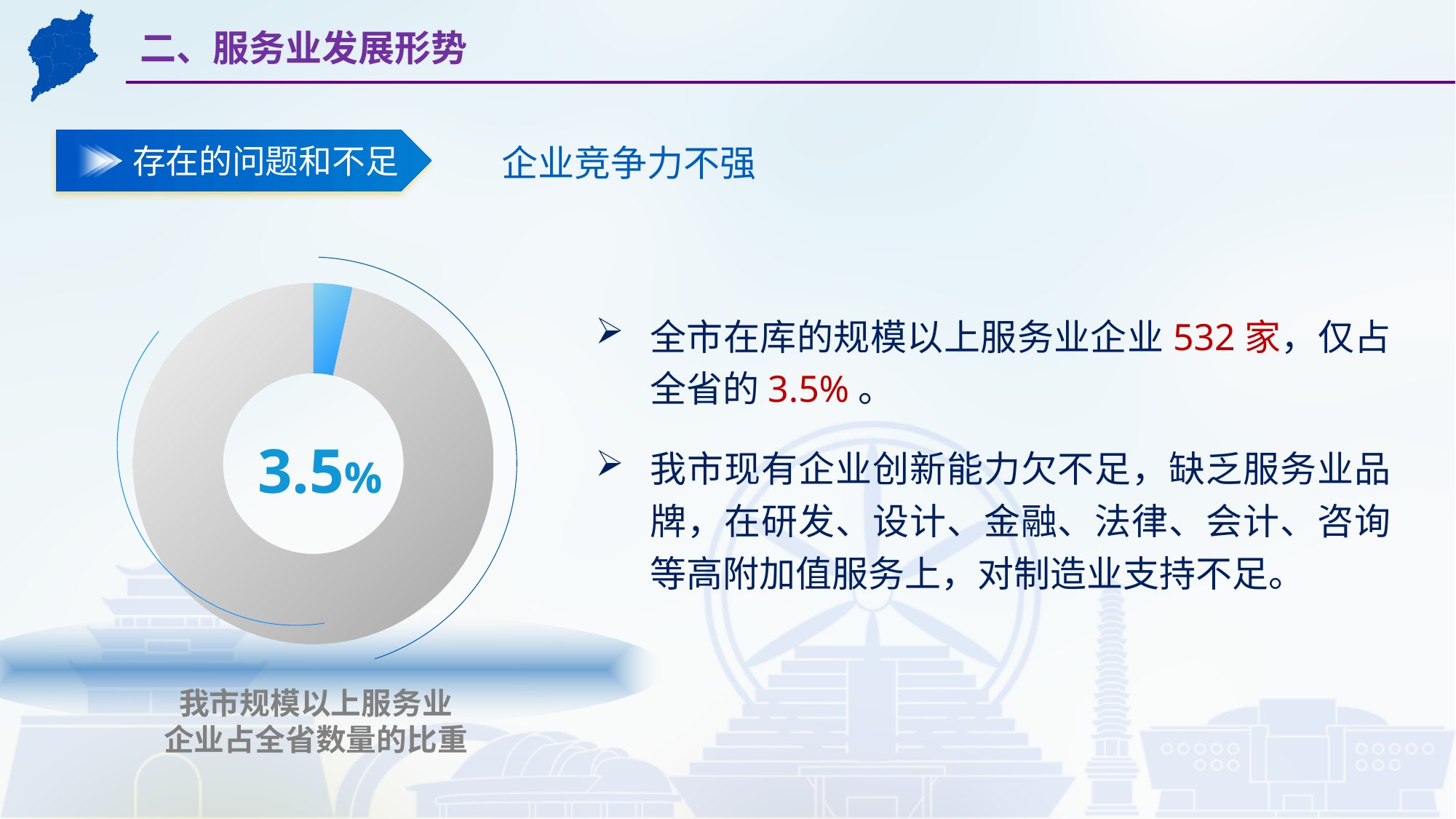
Is the share of the blue slice in the donut chart greater or less than 50%? less What share of the donut chart does the blue slice represent? 3.5% Which slice of the donut chart is the smallest? the blue slice (3.5%) What is the caption written below the donut chart? 我市规模以上服务业企业占全省数量的比重 What kind of chart is shown on the left of the slide? pie chart (donut) How many slices does the donut chart have? 2 What colour is the highlighted 3.5% slice in the donut chart? blue Which slice of the donut chart is larger, the blue one or the grey one? the grey one What value is printed in the centre of the donut chart? 3.5%